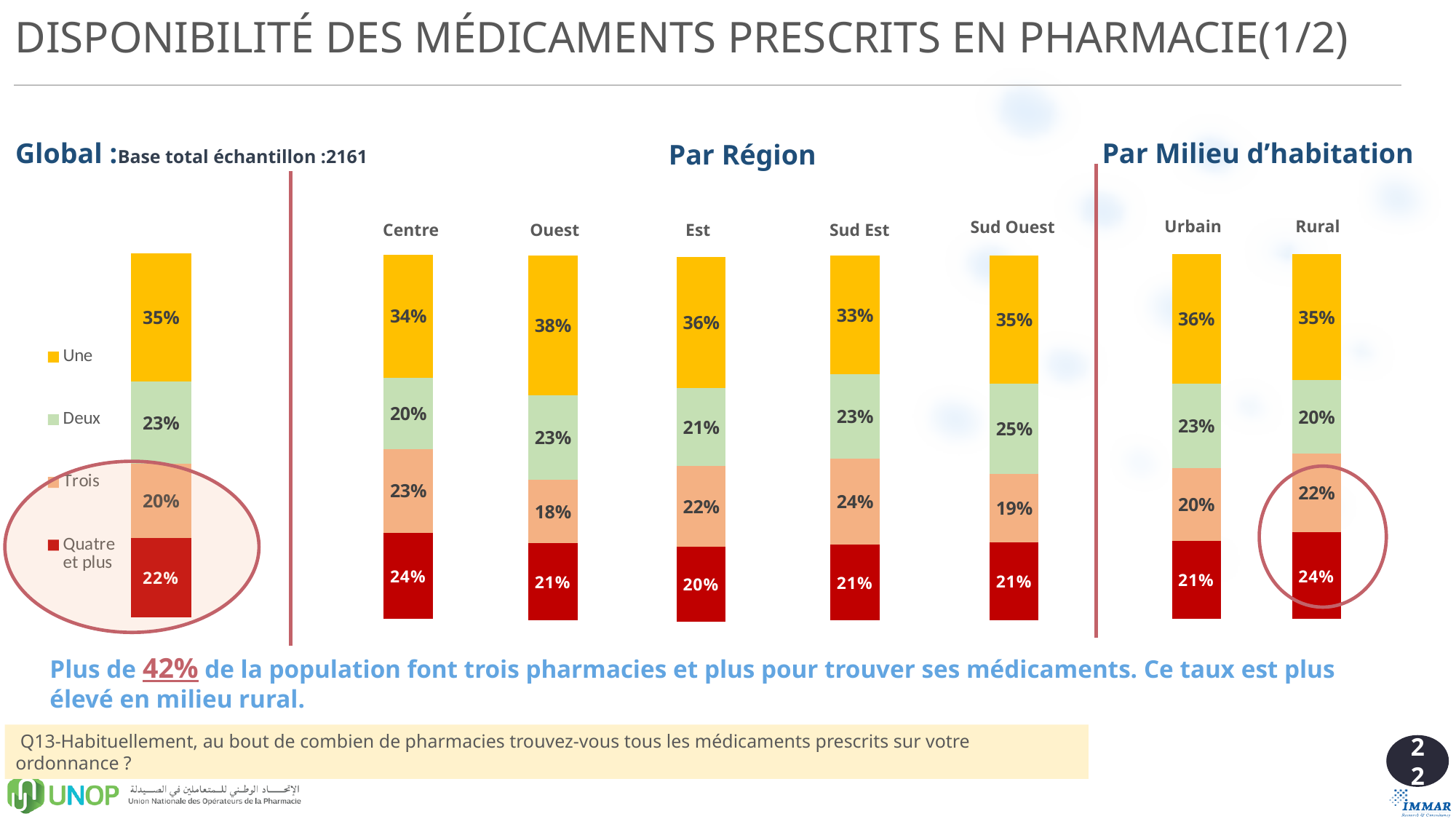
In the Par Région chart, what is the 'Deux' value for Sud Ouest? 25% In the Par Région chart, which region has the lowest 'Une' value? Sud Est In the Global chart, what colour represents the 'Quatre et plus' segment? Red In the Global chart, what percentage is shown for the 'Une' segment? 35% In the Par Région chart, which has the larger 'Trois' value, Sud Est or Ouest? Sud Est In the Par Milieu d'habitation chart, what is the 'Quatre et plus' value for Rural? 24% In the Par Région chart, what is the 'Une' value for Ouest? 38% What type of chart is used on this slide? Stacked bar chart In the Par Région chart, which region has the highest 'Quatre et plus' value? Centre How many regions are shown in the Par Région chart? 5 How many series does the legend of the Global chart list? 4 In the Par Milieu d'habitation chart, what is the difference between the 'Quatre et plus' values for Rural and Urbain? 3 percentage points